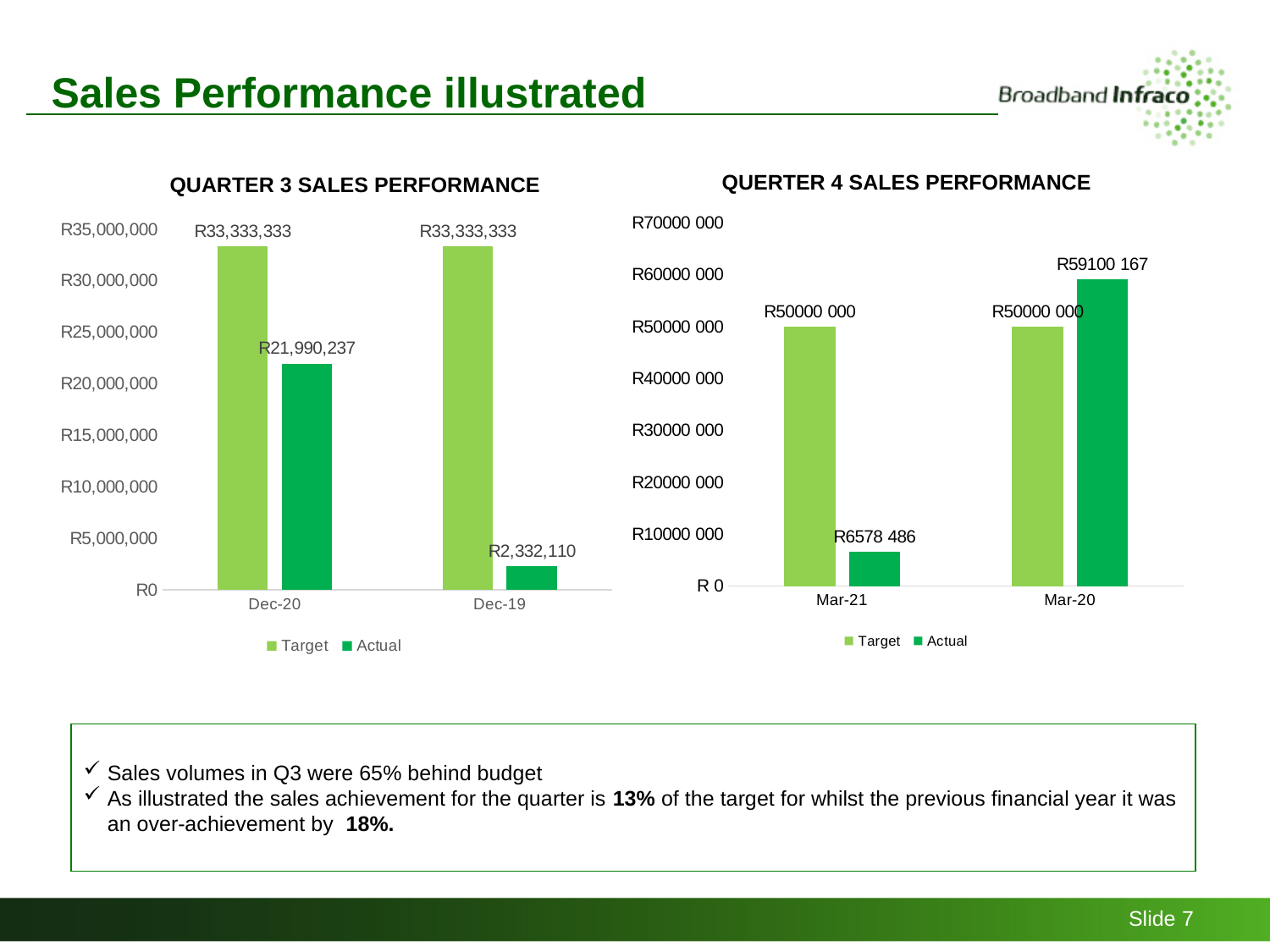
In the Querter 4 Sales Performance chart, what is the Target value for Mar-21? R50000 000 In the Quarter 3 Sales Performance chart, what is the Actual value for Dec-20? R21,990,237 In the Querter 4 Sales Performance chart, what is the Actual value for Mar-21? R6578 486 In the Querter 4 Sales Performance chart, what is the Actual value for Mar-20? R59100 167 In the Quarter 3 Sales Performance chart, which category has the lower Actual value, Dec-20 or Dec-19? Dec-19 In the Querter 4 Sales Performance chart, is the Actual value for Mar-21 larger or smaller than the Target for Mar-21? smaller In the Quarter 3 Sales Performance chart, what is the difference between the Target and Actual values for Dec-20? R11,343,096 In the Quarter 3 Sales Performance chart, what is the Target value for Dec-20? R33,333,333 In the Quarter 3 Sales Performance chart, what is the Actual value for Dec-19? R2,332,110 What type of chart is the Querter 4 Sales Performance chart? bar chart In the Querter 4 Sales Performance chart, by how much does the Actual value for Mar-20 exceed its Target? R9100 167 In the Quarter 3 Sales Performance chart, how many series does the legend list? 2